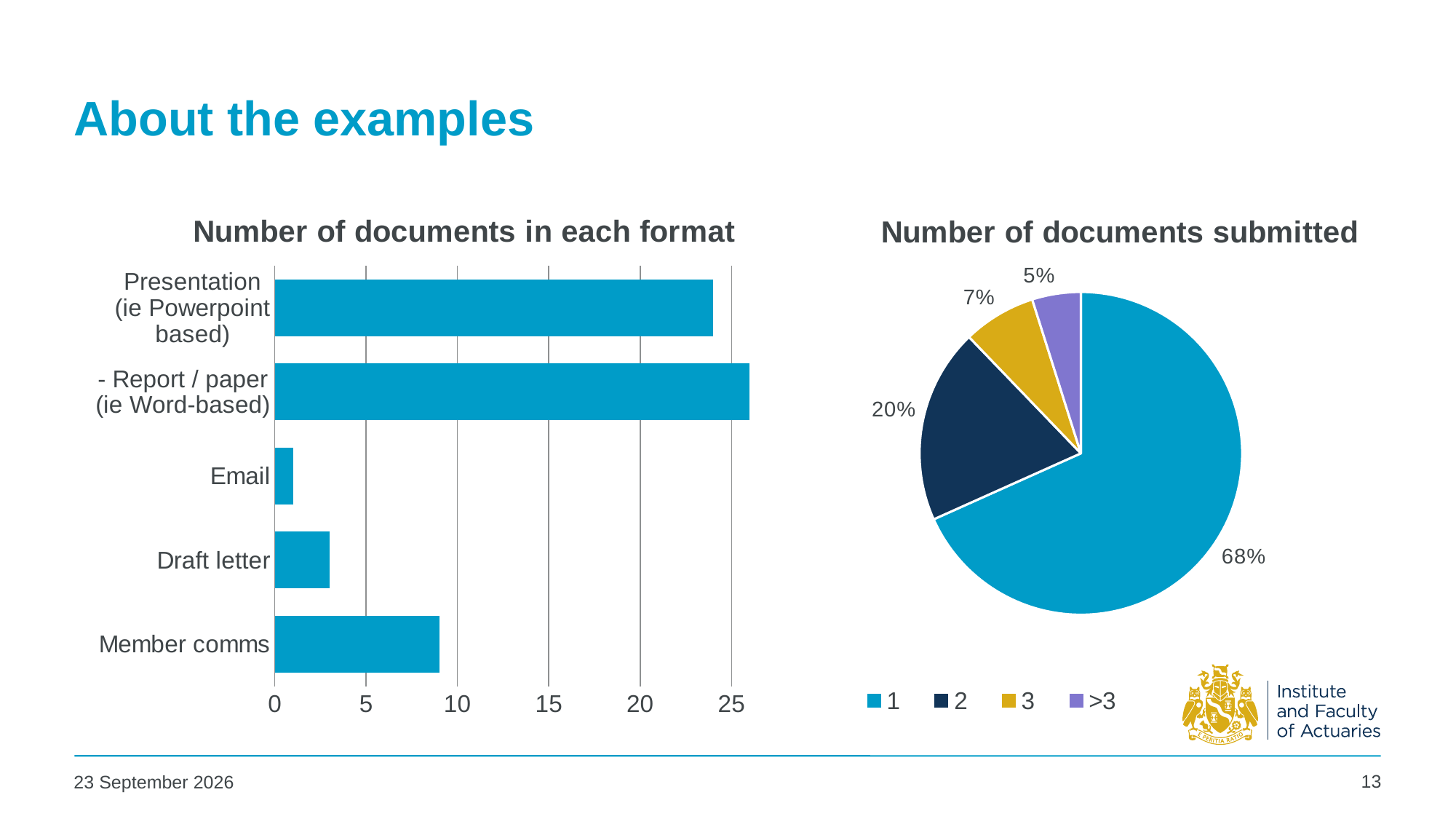
In the 'Number of documents in each format' chart, which format has the lowest number of documents? Email What kind of chart is 'Number of documents in each format'? Bar chart In the 'Number of documents submitted' pie chart, what is the difference in percentage points between the '2' slice and the '>3' slice? 15 How many formats are shown in the 'Number of documents in each format' chart? 5 In the 'Number of documents in each format' chart, is the value for Presentation (ie Powerpoint based) greater or less than 20? greater In the 'Number of documents in each format' chart, which has more documents, Draft letter or Member comms? Member comms How many entries does the legend of the 'Number of documents submitted' pie chart list? 4 In the 'Number of documents submitted' pie chart, what percentage is shown for the '3' slice? 7% In the 'Number of documents in each format' chart, is the value for Draft letter greater or less than 5? less In the 'Number of documents in each format' chart, is the value for Member comms greater or less than 5? greater In the 'Number of documents in each format' chart, which format has the highest number of documents? - Report / paper (ie Word-based) In the 'Number of documents submitted' pie chart, what share is labelled for the '1' slice? 68%